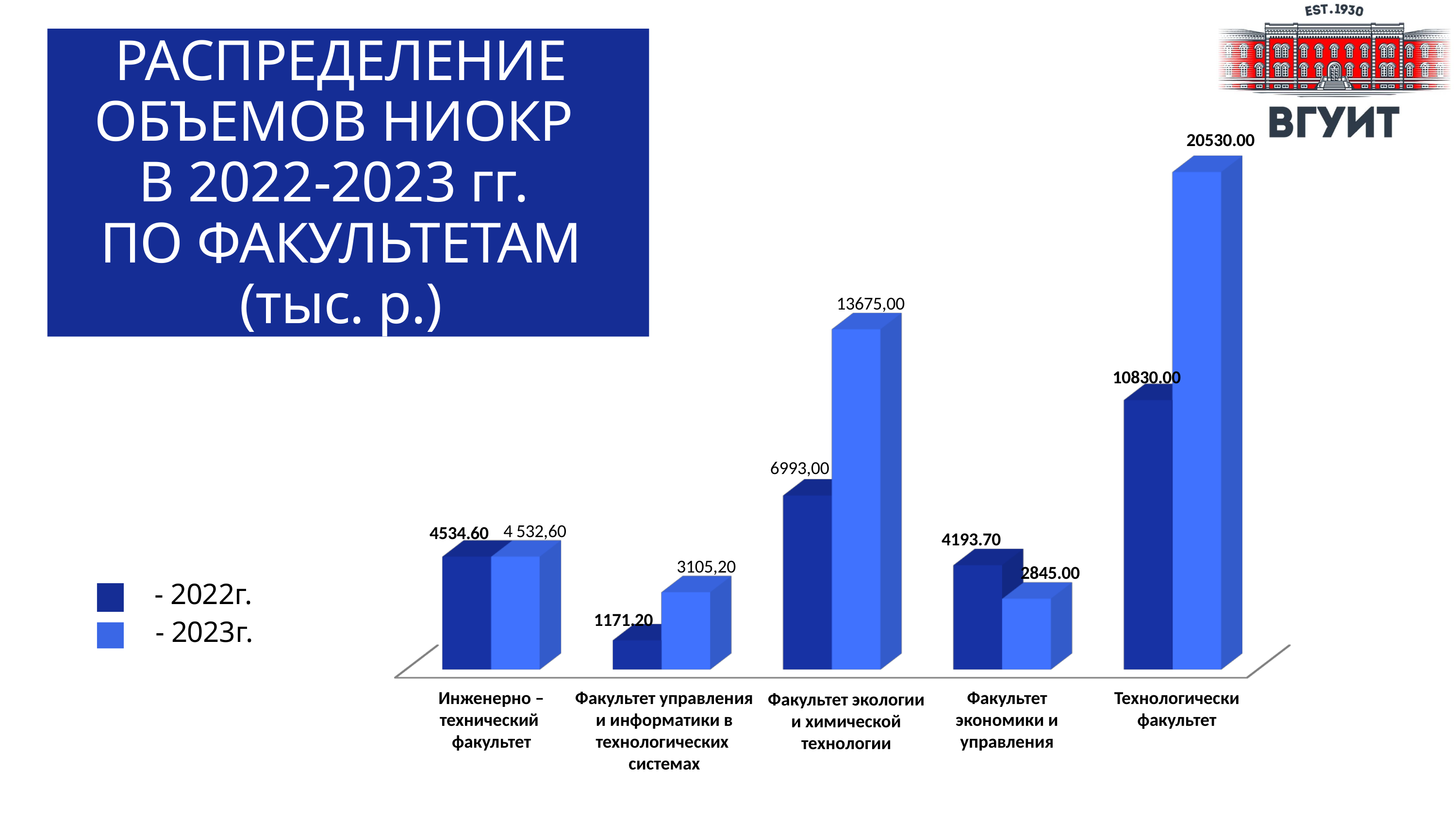
Which faculty had the lowest R&D volume in 2022? Факультет управления и информатики в технологических системах How many faculties are shown on the chart? 5 By how much did the R&D volume for Технологический факультет increase from 2022 to 2023? 9700.00 What was the R&D volume for Факультет экономики и управления in 2022? 4193.70 What is the difference between the 2023 and 2022 R&D volumes for Факультет экологии и химической технологии? 6682,00 What was the R&D volume for Факультет экологии и химической технологии in 2022? 6993,00 What was the R&D volume for Технологический факультет in 2023? 20530.00 What was the R&D volume for Факультет управления и информатики в технологических системах in 2023? 3105,20 What type of chart is shown on the slide? Bar chart Which faculty had the highest R&D volume in 2023? Технологический факультет For Факультет экономики и управления, which year had the larger R&D volume, 2022 or 2023? 2022 How many series does the legend list? 2